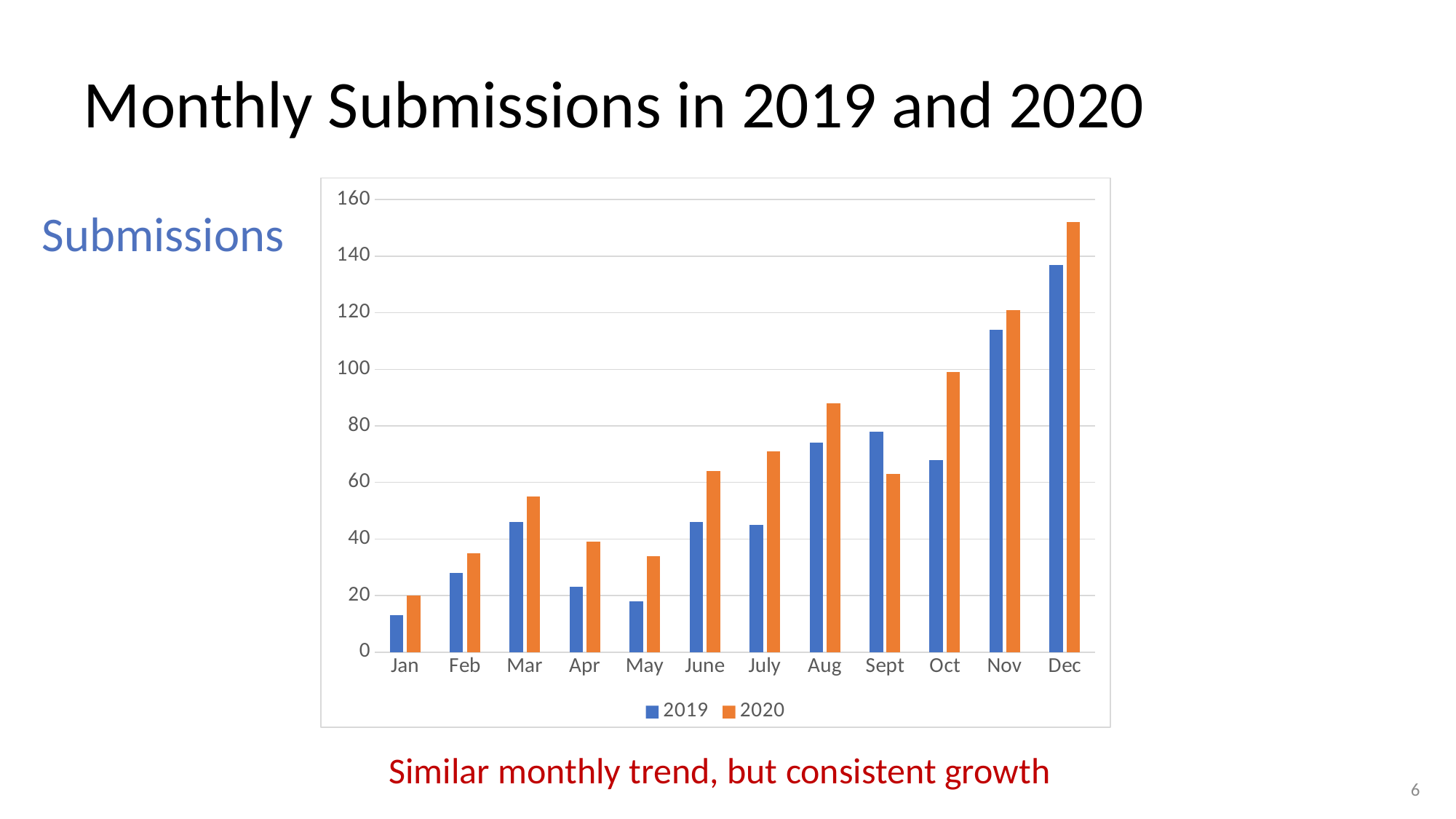
Which month has the lowest number of submissions in 2019? Jan In Sept, which year had more submissions, 2019 or 2020? 2019 Is the value for Dec 2020 greater or less than 140? greater How many months are shown on the x axis? 12 Is the value for Nov 2019 greater or less than 100? greater Is the value for May 2020 greater or less than 40? less How many series does the legend list? 2 Which month has the highest number of submissions in 2019? Dec Which month has the highest number of submissions in 2020? Dec What kind of chart is shown on the slide? bar chart In Oct, which year had more submissions, 2019 or 2020? 2020 Which colour represents the 2020 series in the legend? orange